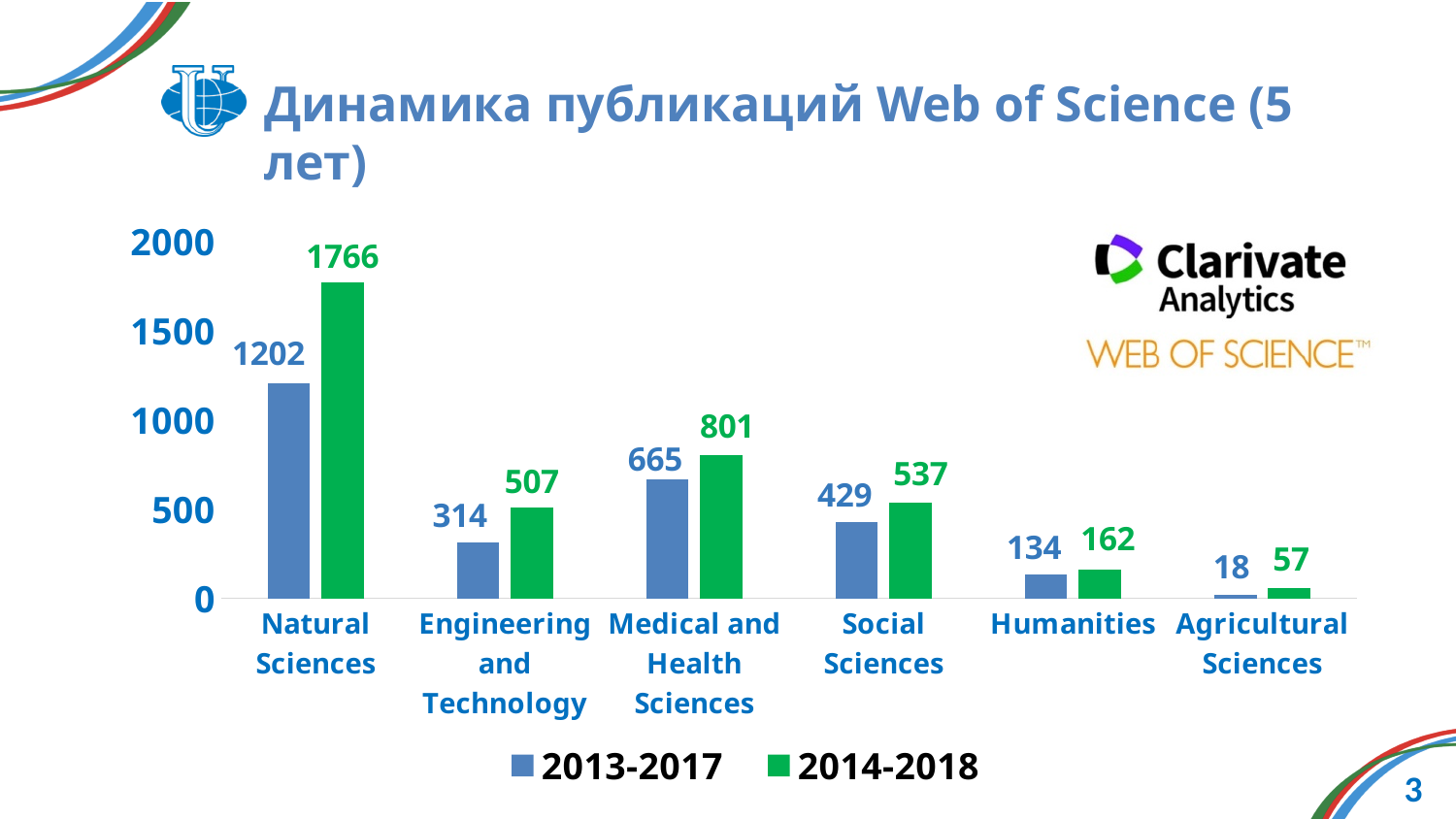
What is the value for Natural Sciences in the 2014-2018 series? 1766 Which category has the lowest value in the 2014-2018 series? Agricultural Sciences What is the value for Engineering and Technology in the 2013-2017 series? 314 What is the value for Humanities in the 2014-2018 series? 162 How many categories are shown on the x axis? 6 Is the 2013-2017 value for Natural Sciences greater or less than 1000? greater Which colour represents the 2014-2018 series? green What is the difference between the 2014-2018 and 2013-2017 values for Medical and Health Sciences? 136 Which category has the highest value in the 2013-2017 series? Natural Sciences Which is larger: the 2013-2017 value for Social Sciences or the 2014-2018 value for Engineering and Technology? 2014-2018 value for Engineering and Technology What kind of chart is shown on the slide? bar chart How many series does the legend list? 2